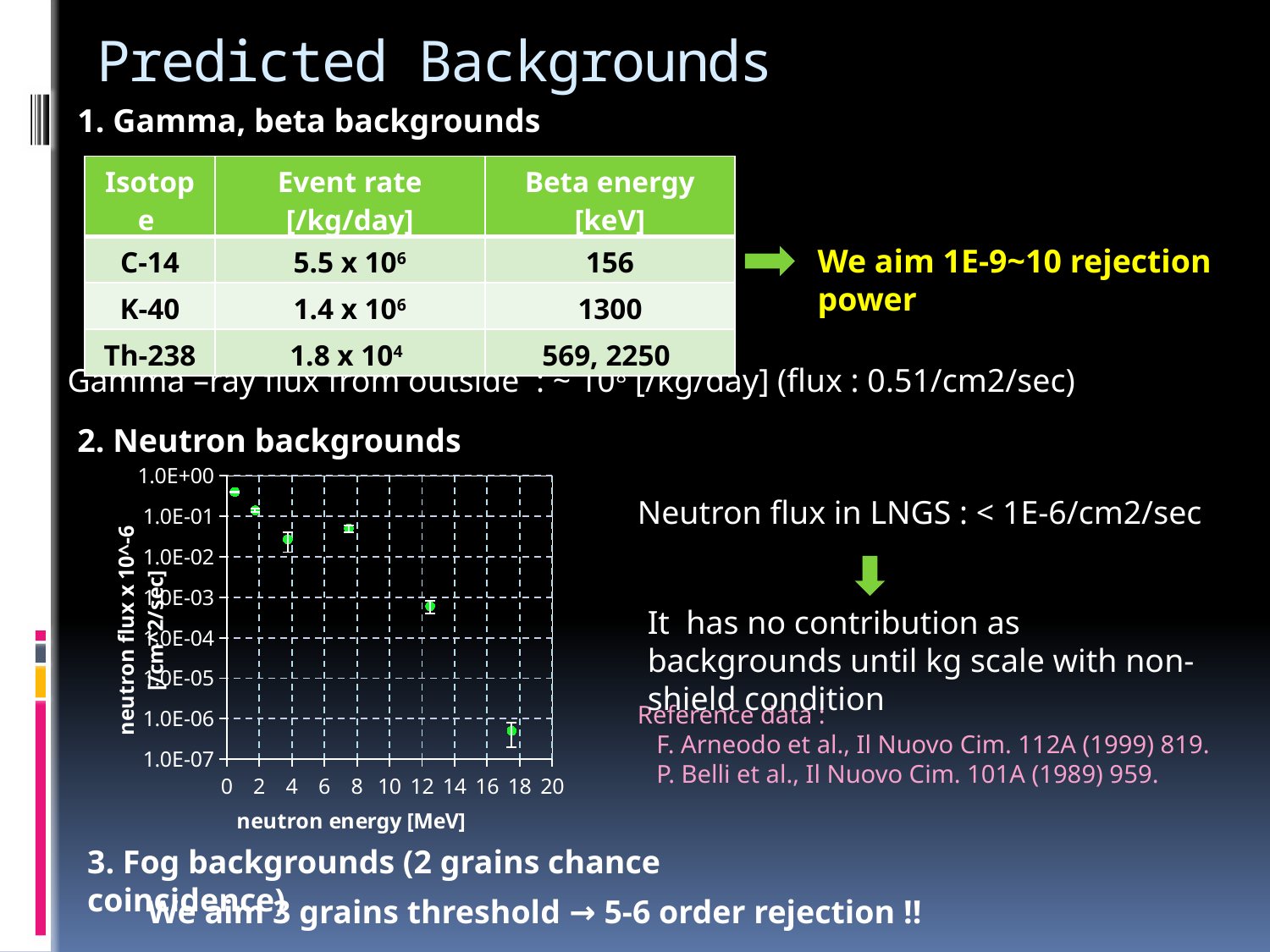
In the neutron flux chart, which data point has the lowest neutron flux? the one near 18 MeV In the neutron flux chart, is the value of the data point near 18 MeV greater or less than 1.0E-05? less In the neutron flux chart, is the value of the first data point (near 0 MeV) greater or less than 1.0E-01? greater In the neutron flux chart, is the value of the data point near 12 MeV greater or less than 1.0E-02? less In the neutron flux chart, do the values generally rise or fall as neutron energy increases? fall What kind of chart is shown under '2. Neutron backgrounds'? scatter chart What is the highest tick value shown on the y axis of the neutron flux chart? 1.0E+00 What is the label of the x axis of the neutron flux chart? neutron energy [MeV] In the neutron flux chart, which data point has the highest neutron flux: the one near 0 MeV or the one near 18 MeV? the one near 0 MeV How many data points are plotted in the neutron flux chart? 6